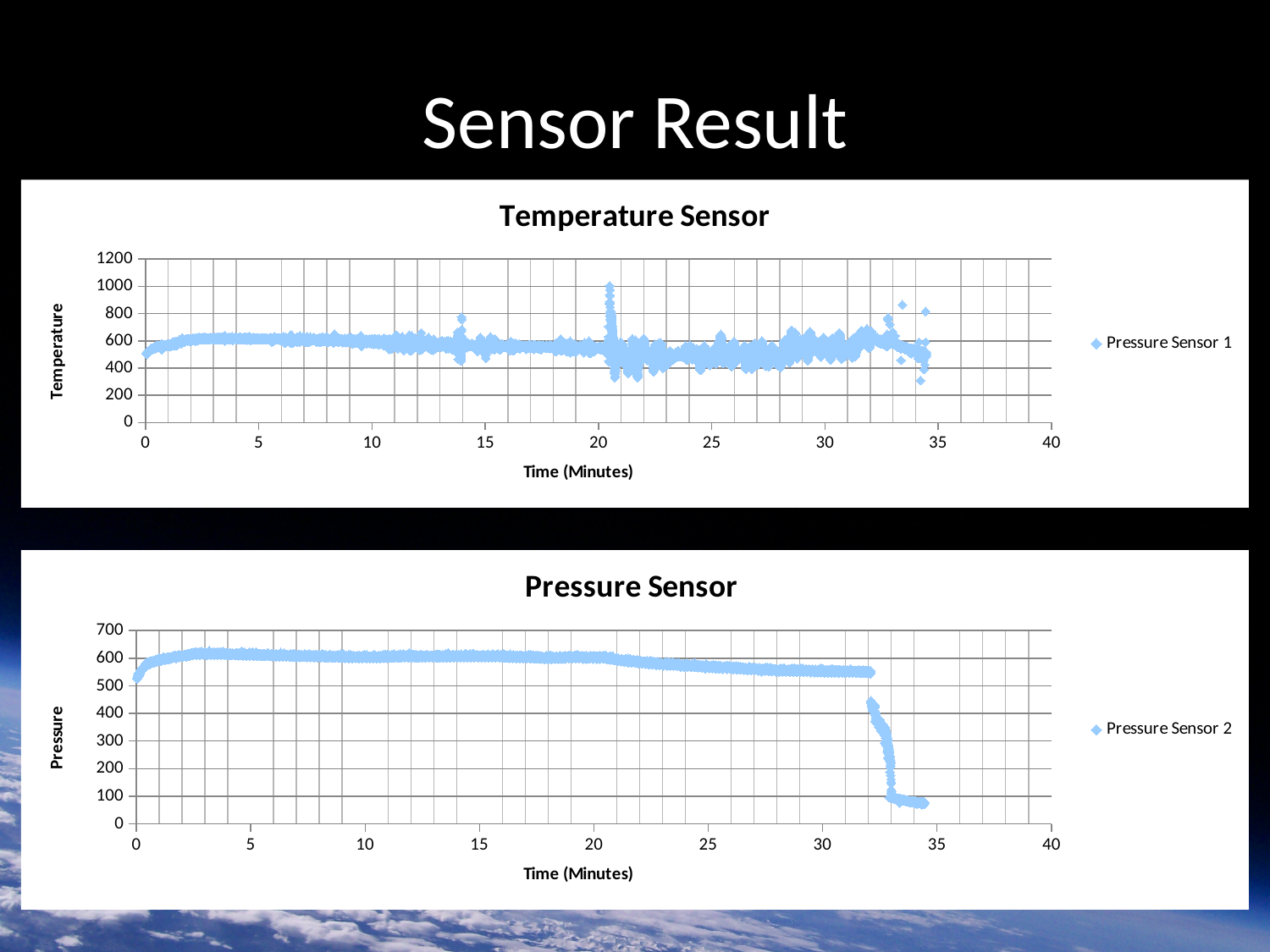
What kind of chart is the Pressure Sensor chart? scatter chart What is the legend entry on the Pressure Sensor chart? Pressure Sensor 2 In the Temperature Sensor chart, is the highest spike near 20 minutes greater or less than 800? greater How many series does the legend of the Pressure Sensor chart list? 1 In the Pressure Sensor chart, do the values rise or fall between 20 and 30 minutes? fall How many series does the legend of the Temperature Sensor chart list? 1 In the Pressure Sensor chart, is the value at 34 minutes greater or less than 100? less What is the x-axis title on the Temperature Sensor chart? Time (Minutes) In the Pressure Sensor chart, is the value at 10 minutes greater or less than 500? greater In the Pressure Sensor chart, do the values rise or fall between 30 and 35 minutes? fall What kind of chart is the Temperature Sensor chart? scatter chart